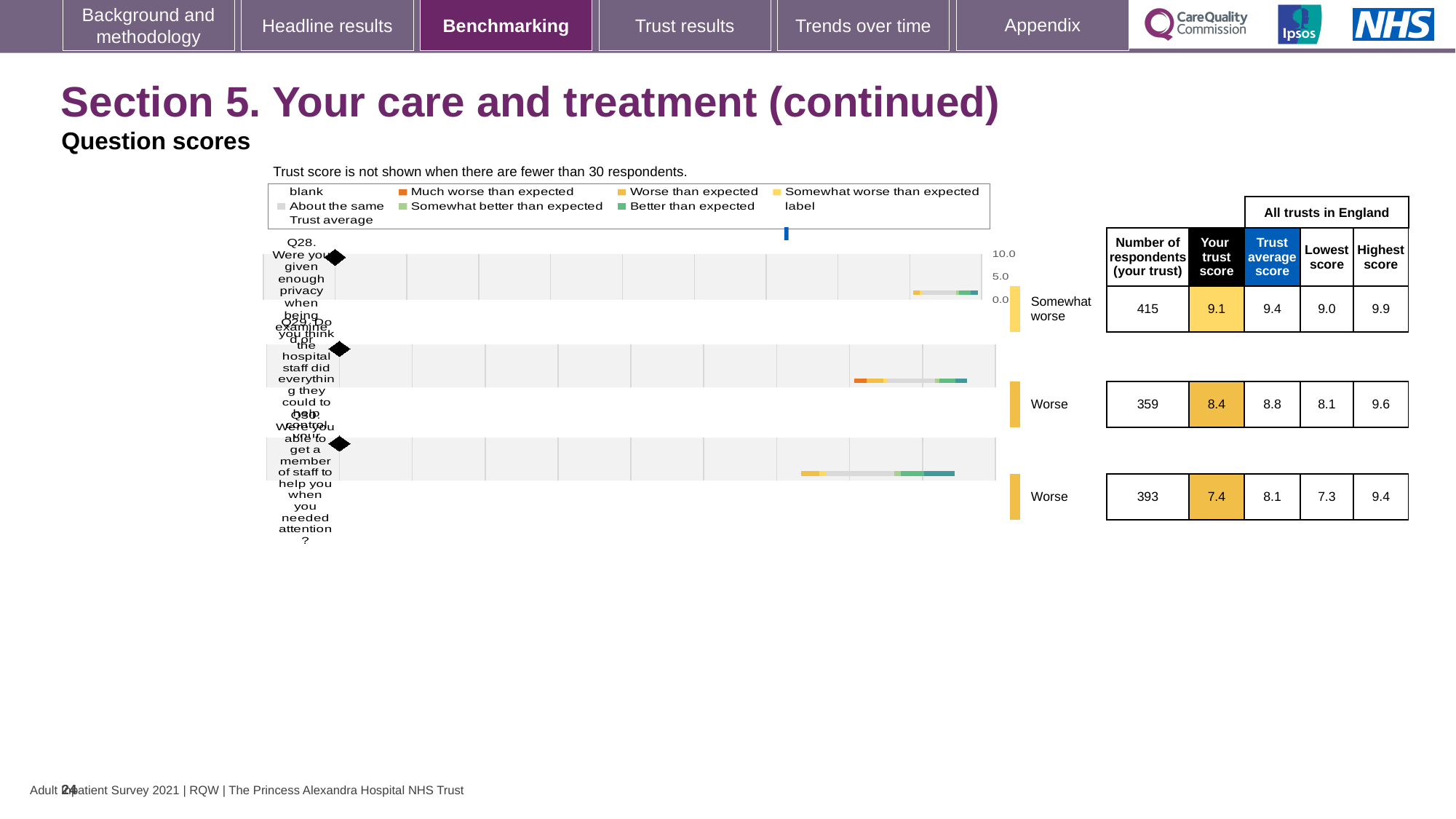
Which question has the lowest trust score? Q30 What is the lowest score across all trusts in England for Q30? 7.3 How many respondents answered Q30 at this trust? 393 What benchmark category is shown for Q28? Somewhat worse What is the difference between the trust average score and the trust score for Q30? 0.7 What is the maximum value shown on the chart's score axis? 10.0 Which question has the highest trust score? Q28 What is the highest score across all trusts in England for Q28? 9.9 How many questions are plotted on the chart? 3 What is the trust score for Q28? 9.1 What is the trust average score for Q29? 8.8 Which is larger, the trust score for Q29 or the trust score for Q30? Q29